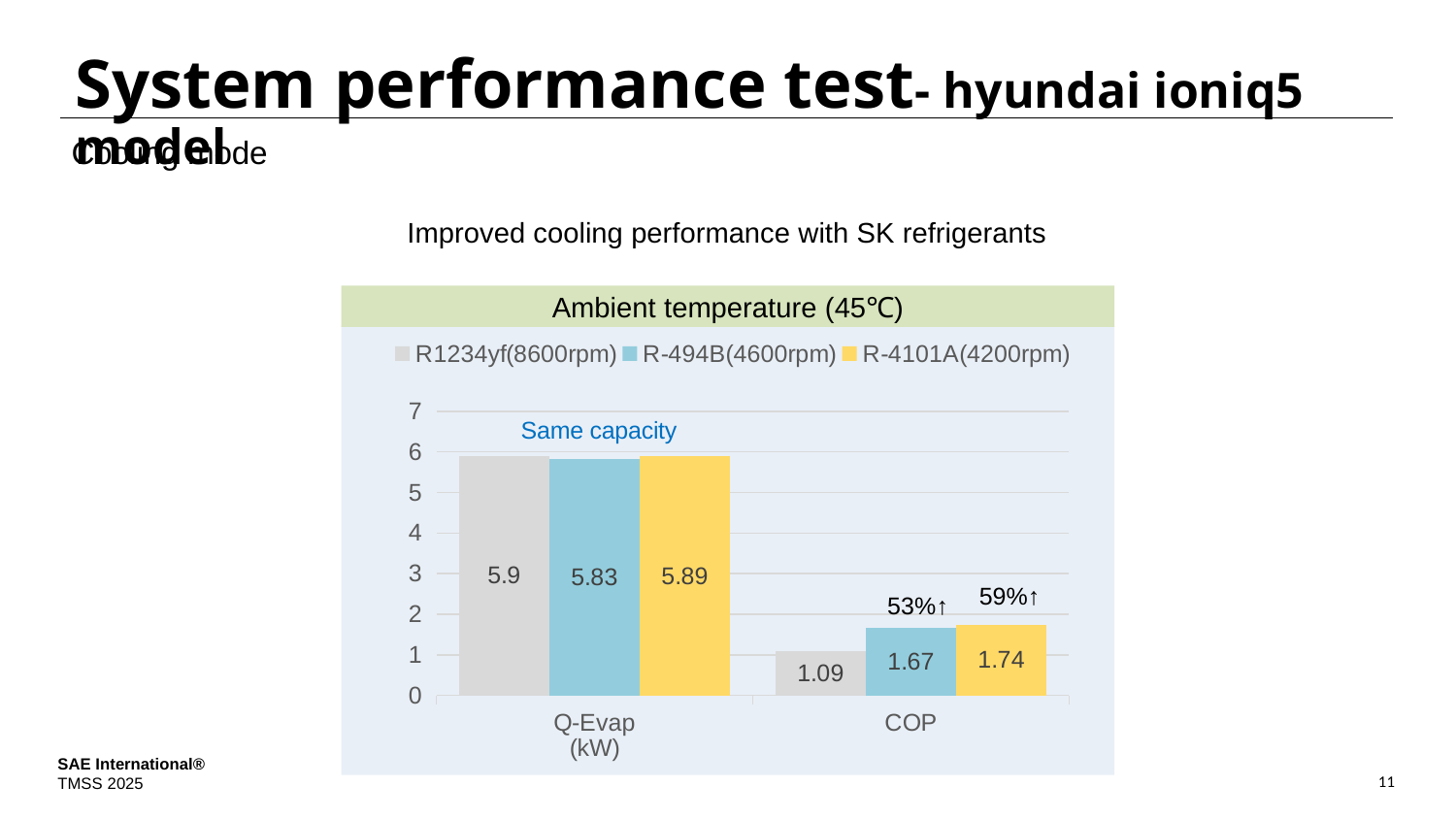
What percentage increase is annotated above the R-4101A(4200rpm) COP bar? 59%↑ What is the title of the chart? Ambient temperature (45℃) What kind of chart is shown on the slide? bar chart What is the COP value for R-4101A(4200rpm)? 1.74 What is the difference between the COP values of R-4101A(4200rpm) and R1234yf(8600rpm)? 0.65 What is the COP value for R-494B(4600rpm)? 1.67 How many categories are shown on the x axis? 2 Which series has the lowest COP value? R1234yf(8600rpm) Which is larger: the COP of R-494B(4600rpm) or the COP of R1234yf(8600rpm)? R-494B(4600rpm) What is the Q-Evap (kW) value for R1234yf(8600rpm)? 5.9 What is the Q-Evap (kW) value for R-494B(4600rpm)? 5.83 How many series does the legend list? 3